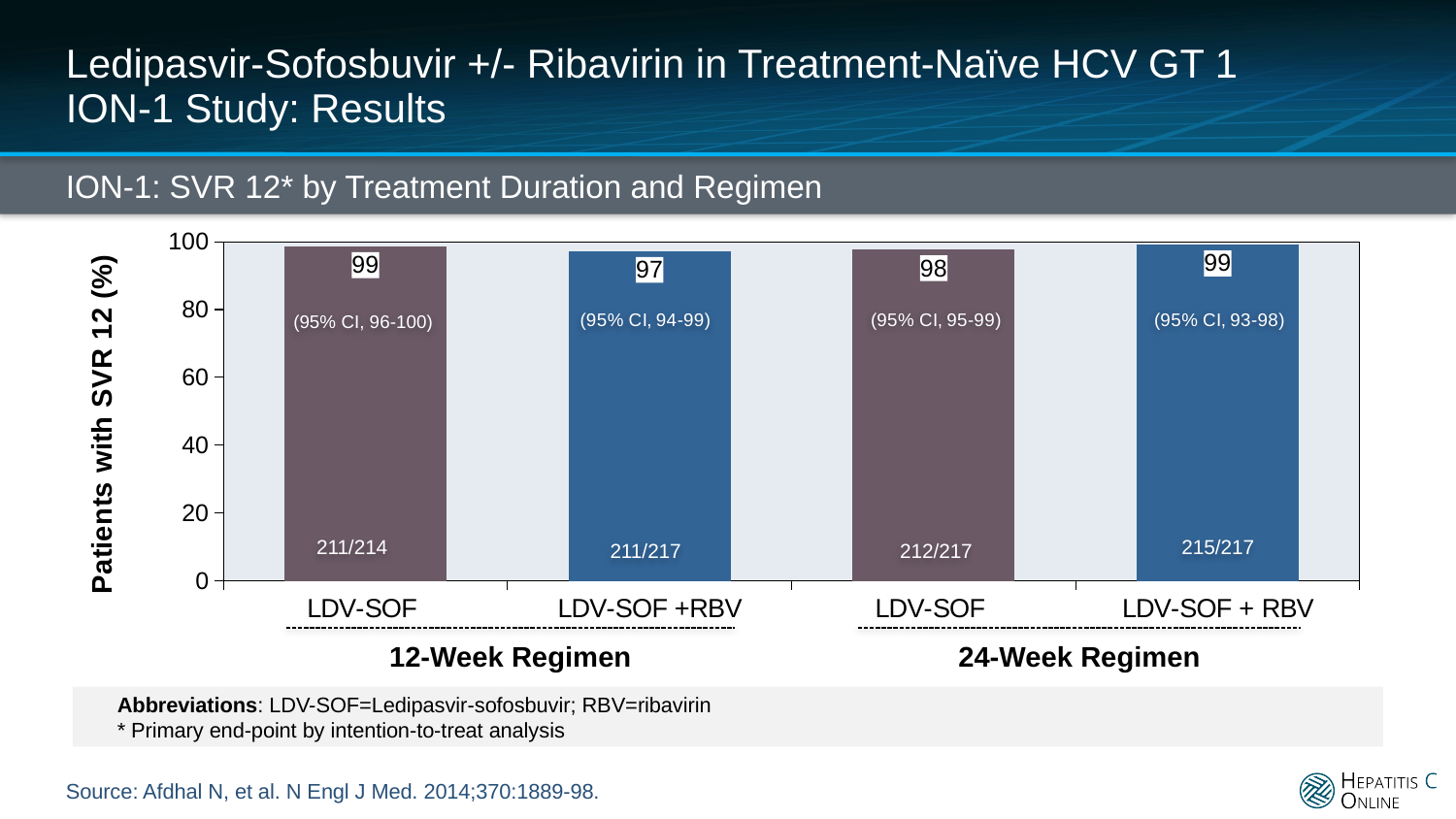
What kind of chart is shown on the slide? Bar chart Which has a higher SVR 12 rate: LDV-SOF in the 24-Week Regimen or LDV-SOF +RBV in the 12-Week Regimen? LDV-SOF in the 24-Week Regimen What is the SVR 12 rate for LDV-SOF + RBV in the 24-Week Regimen? 99 What is the SVR 12 rate for LDV-SOF +RBV in the 12-Week Regimen? 97 What is the difference in SVR 12 rate between LDV-SOF and LDV-SOF +RBV in the 12-Week Regimen? 2 How many bars are shown in the chart? 4 Which bar has the lowest SVR 12 rate? LDV-SOF +RBV, 12-Week Regimen What is the SVR 12 rate for LDV-SOF in the 12-Week Regimen? 99 Is the SVR 12 rate for LDV-SOF +RBV in the 12-Week Regimen greater or less than 80? greater What is the patient fraction shown for LDV-SOF + RBV in the 24-Week Regimen? 215/217 What is the label of the y-axis? Patients with SVR 12 (%) What is the SVR 12 rate for LDV-SOF in the 24-Week Regimen? 98